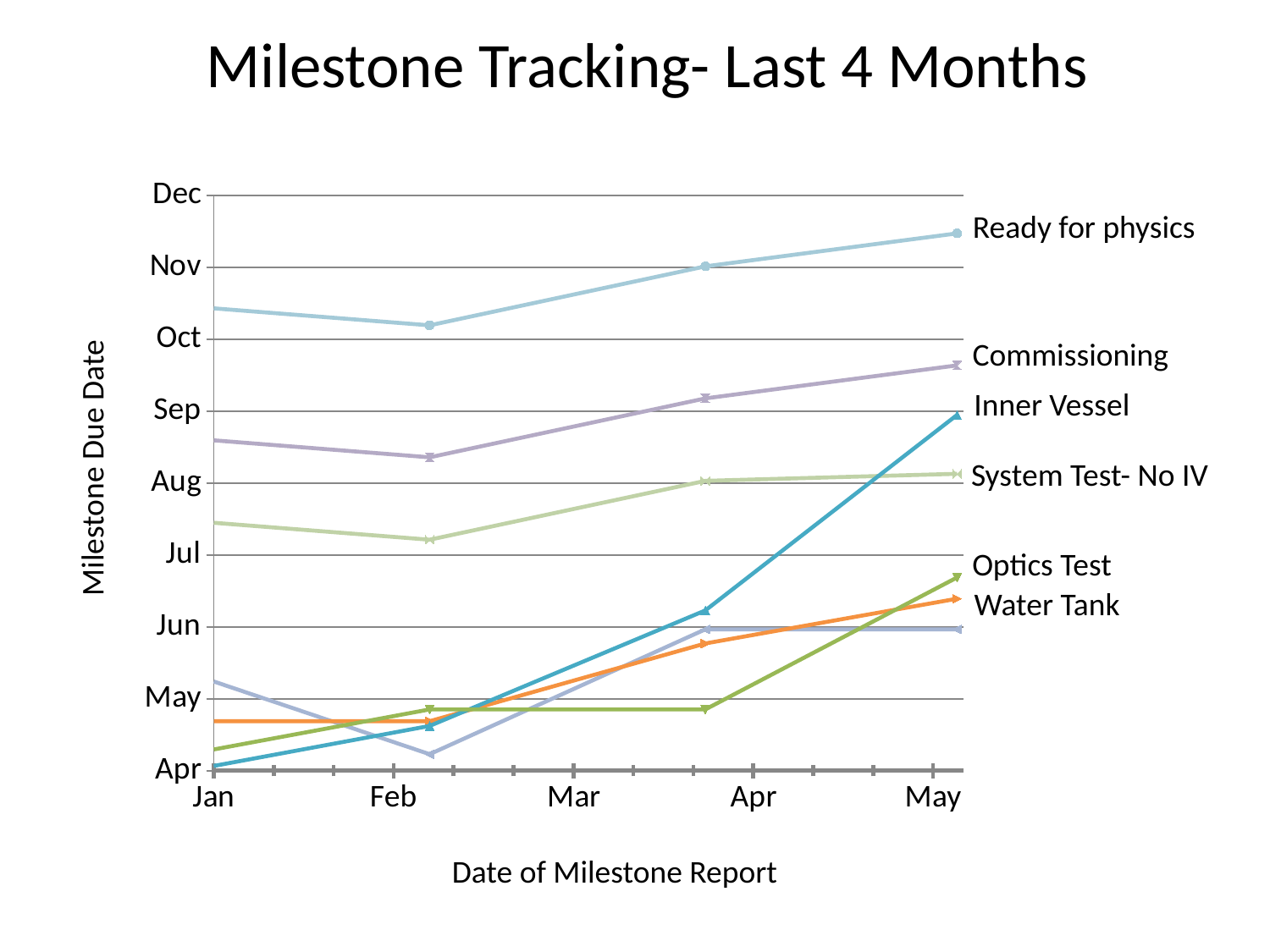
What type of chart is shown on the slide? line chart Is the due date for Optics Test at the May report later or earlier than Jul? earlier At the May report, which milestone has the later due date: Inner Vessel or System Test- No IV? Inner Vessel What is the title of the chart? Milestone Tracking- Last 4 Months Which milestone has the earliest due date at the Jan report? Inner Vessel Is the due date for Ready for physics at the May report later or earlier than Nov? later Which milestone has the latest due date at the May report? Ready for physics Does the Inner Vessel due date move later or earlier across the reports from Jan to May? later What is the label of the vertical axis? Milestone Due Date How many report dates (data points) are plotted for each milestone? 4 At the Jan report, which milestone has the later due date: Ready for physics or Commissioning? Ready for physics Is the due date for Commissioning at the May report later or earlier than Oct? earlier